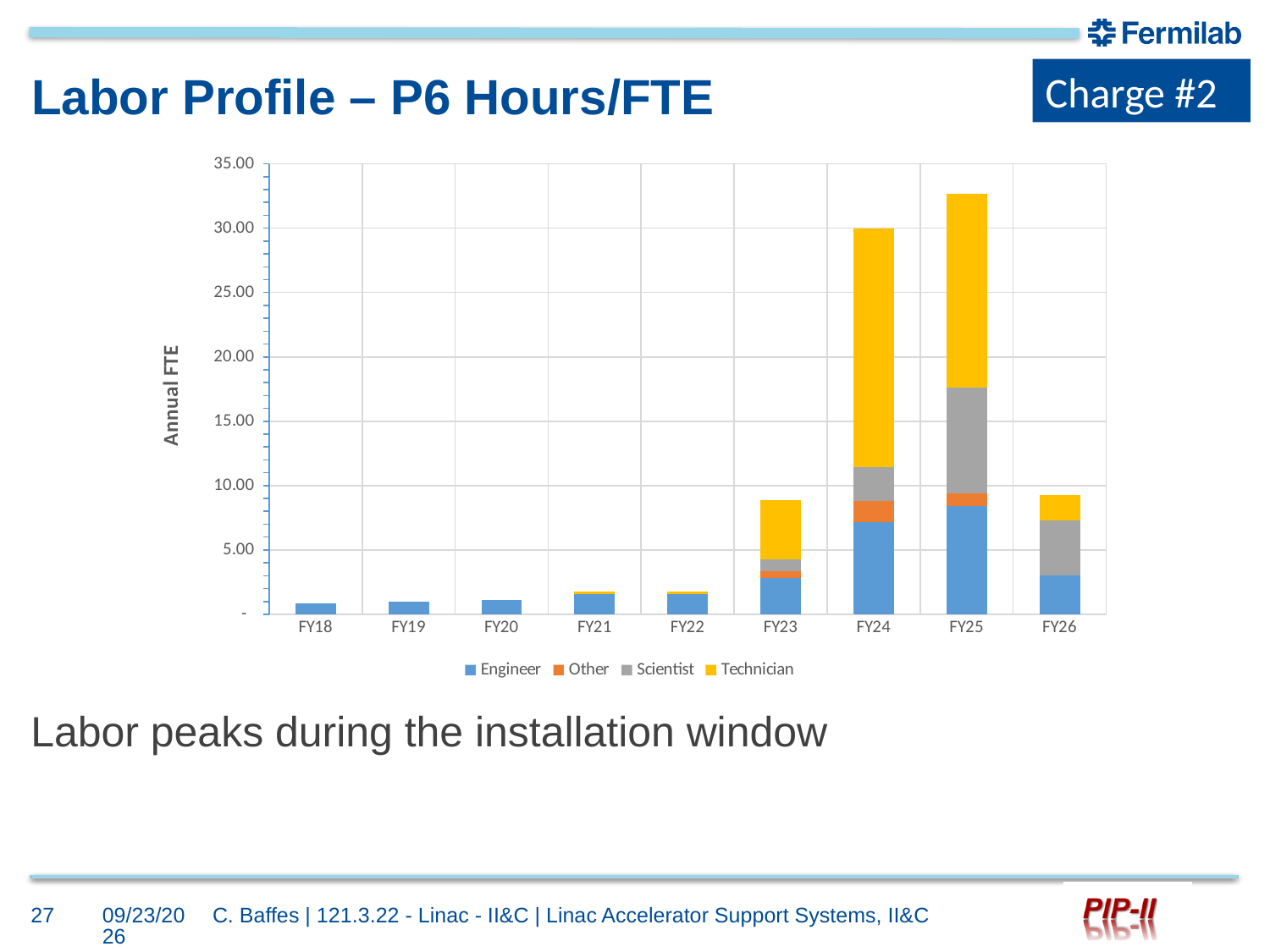
Is the total Annual FTE for FY20 greater or less than 5.00? less Do the total Annual FTE values rise or fall from FY18 to FY25? rise What kind of chart is shown on the slide? Stacked bar chart How many fiscal years are shown on the x axis of the chart? 9 What is the label on the y axis of the chart? Annual FTE Is the total Annual FTE for FY24 greater or less than 25.00? greater Which series in the legend is shown in yellow? Technician Which fiscal year has the highest total Annual FTE? FY25 Is the total Annual FTE for FY23 greater or less than 10.00? less Which has the larger total Annual FTE, FY24 or FY26? FY24 How many series does the chart legend list? 4